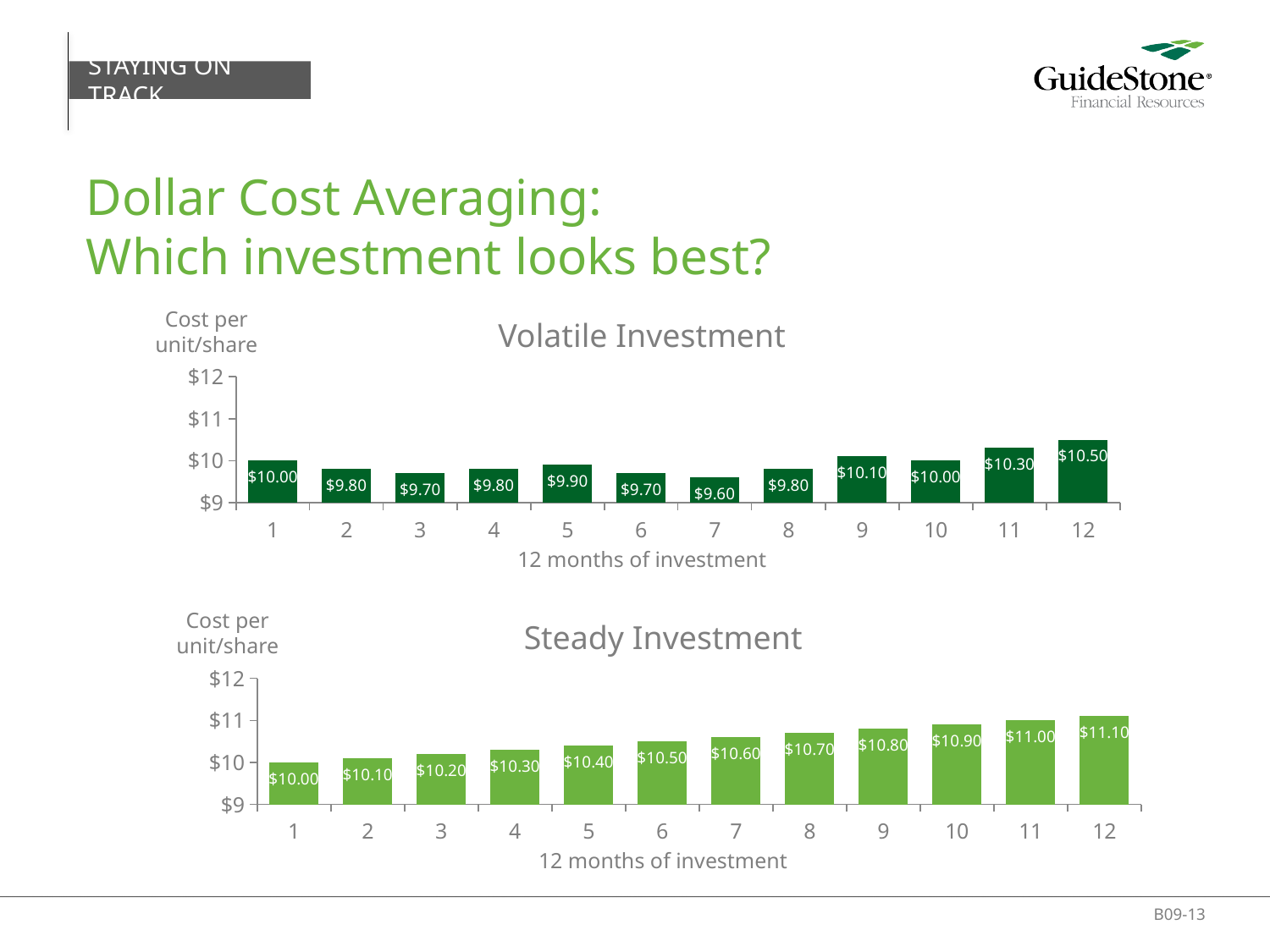
In the Steady Investment chart, which month has the highest cost per unit/share? 12 In the Steady Investment chart, what is the cost per unit/share in month 8? $10.70 In the Volatile Investment chart, which is larger: the cost in month 5 or the cost in month 6? Month 5 In the Volatile Investment chart, which month has the lowest cost per unit/share? 7 In the Steady Investment chart, do the values rise or fall from month 1 to month 12? Rise In the Volatile Investment chart, what is the difference between the cost in month 12 and the cost in month 7? $0.90 In the Volatile Investment chart, what is the cost per unit/share in month 7? $9.60 What kind of chart is the Steady Investment chart? Bar chart How many months are plotted in the Volatile Investment chart? 12 In the Steady Investment chart, is the value for month 11 greater or less than $10? greater In the Volatile Investment chart, which month has the highest cost per unit/share? 12 In the Steady Investment chart, what is the difference between the cost in month 12 and the cost in month 1? $1.10